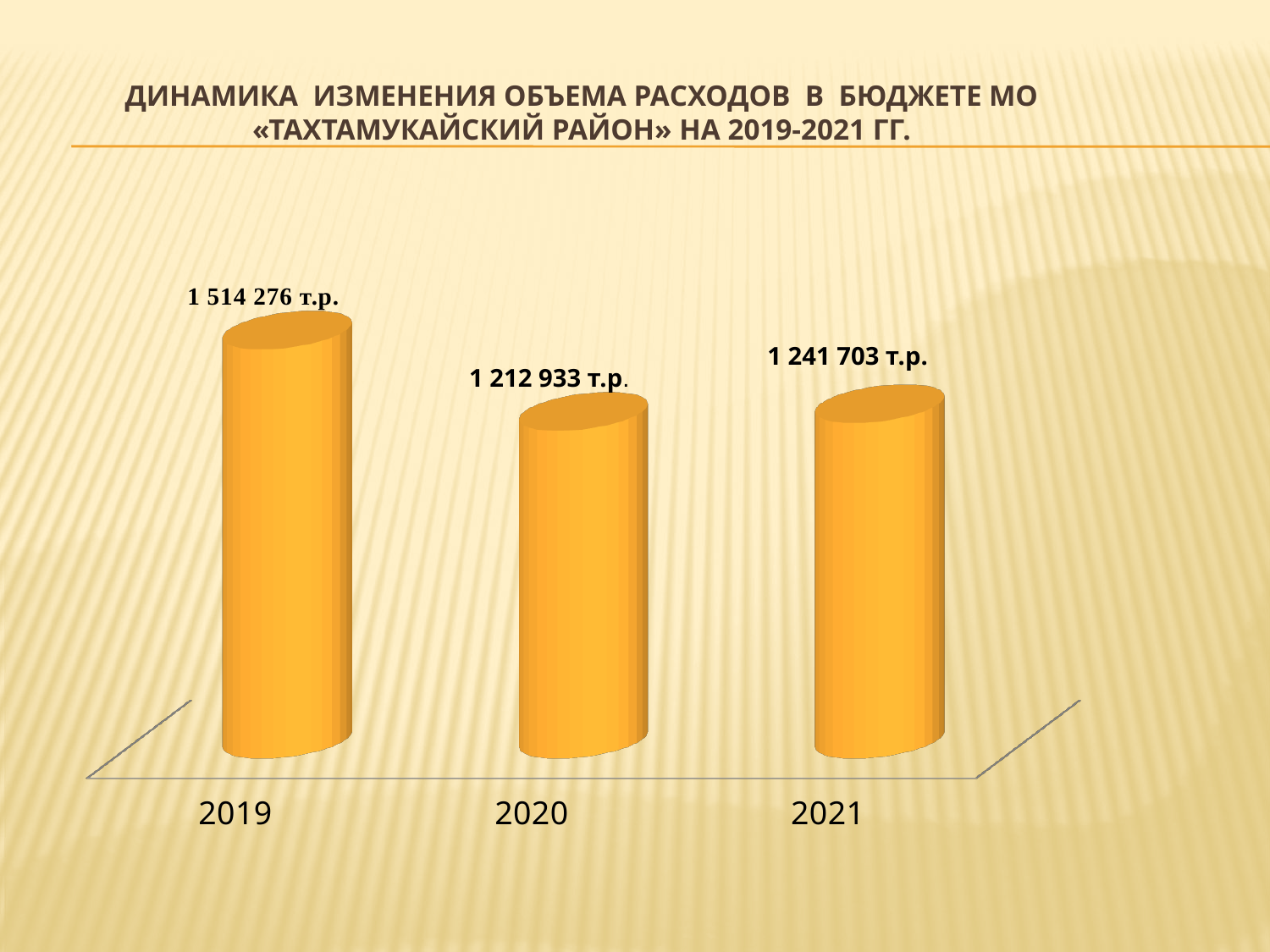
What is the difference between the values for 2021 and 2020? 28 770 т.р. Does the value rise or fall from 2019 to 2020? Fall Which year has the lowest value? 2020 Which is larger, the value for 2019 or the value for 2021? 2019 Which year has the highest value? 2019 What is the value for 2019? 1 514 276 т.р. What is the value for 2020? 1 212 933 т.р. What is the difference between the values for 2019 and 2020? 301 343 т.р. What is the value for 2021? 1 241 703 т.р. What kind of chart is shown on the slide? Bar chart What is the difference between the values for 2019 and 2021? 272 573 т.р. How many years are shown on the chart? 3